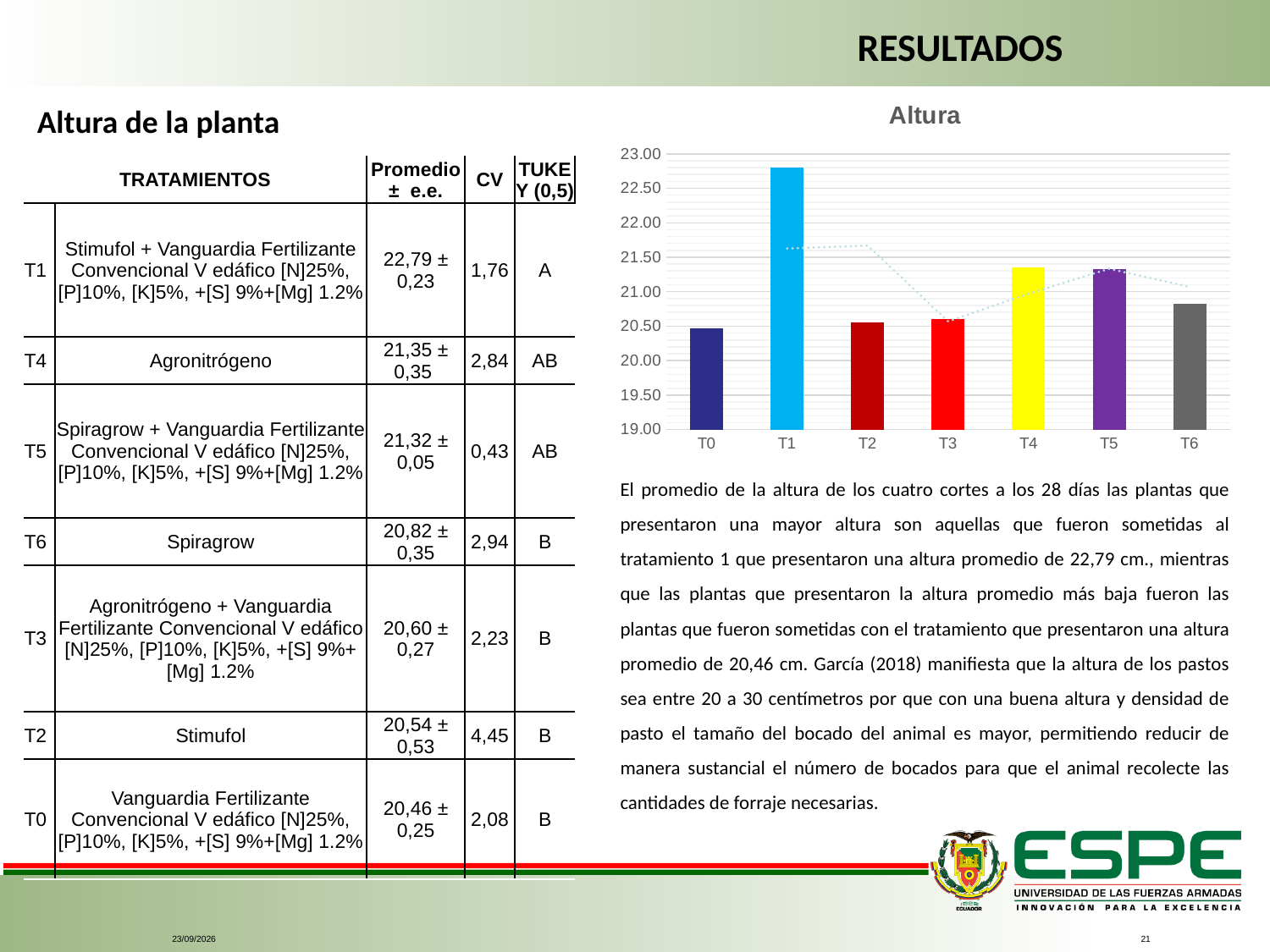
How many treatments (categories) are plotted on the x axis of the chart? 7 Is the value for T6 greater or less than 21.00? less Is the value for T1 greater or less than 22.50? greater Is the value for T4 greater or less than 21.00? greater Which is larger, the value for T1 or the value for T4? T1 Which is larger, the value for T5 or the value for T6? T5 Which treatment has the highest bar in the chart? T1 What is the title of the chart? Altura What is the lowest value shown on the y axis of the chart? 19.00 What kind of chart is shown on the slide? bar chart